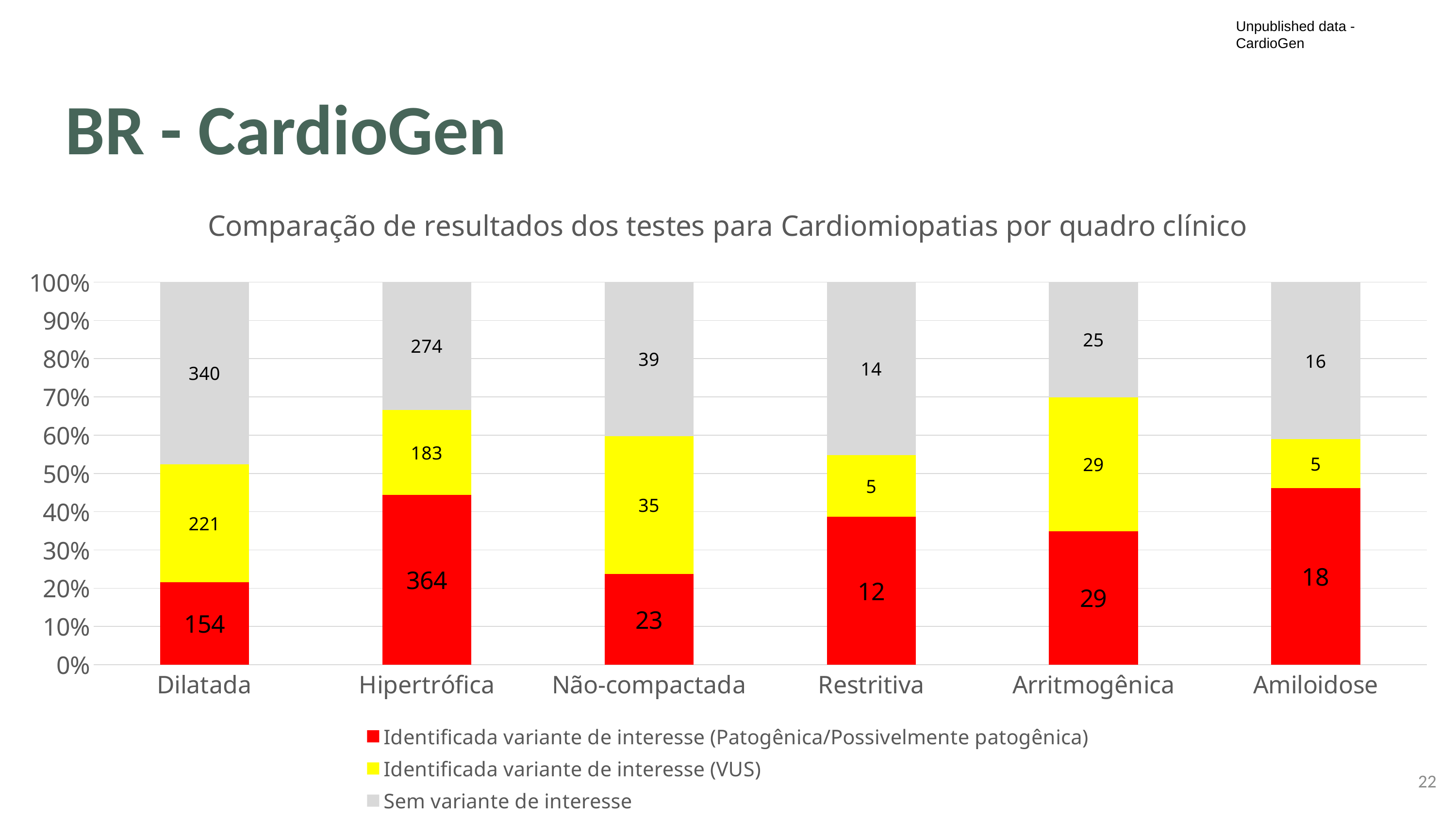
What is the value of the 'Identificada variante de interesse (VUS)' series for Não-compactada? 35 How many categories are shown on the x axis? 6 What kind of chart is shown on the slide? Stacked bar chart What is the difference between the 'Sem variante de interesse' values for Dilatada and Hipertrófica? 66 Which category has the lowest value for the 'Sem variante de interesse' series? Restritiva Which is larger: the 'Identificada variante de interesse (VUS)' value for Dilatada or for Hipertrófica? Dilatada Which category has the highest value for the 'Identificada variante de interesse (Patogênica/Possivelmente patogênica)' series? Hipertrófica What is the total of the three labelled values in the Restritiva bar? 31 What is the value of the 'Sem variante de interesse' series for Dilatada? 340 What is the title of the chart? Comparação de resultados dos testes para Cardiomiopatias por quadro clínico What is the value of the 'Identificada variante de interesse (Patogênica/Possivelmente patogênica)' series for Hipertrófica? 364 How many series does the legend list? 3